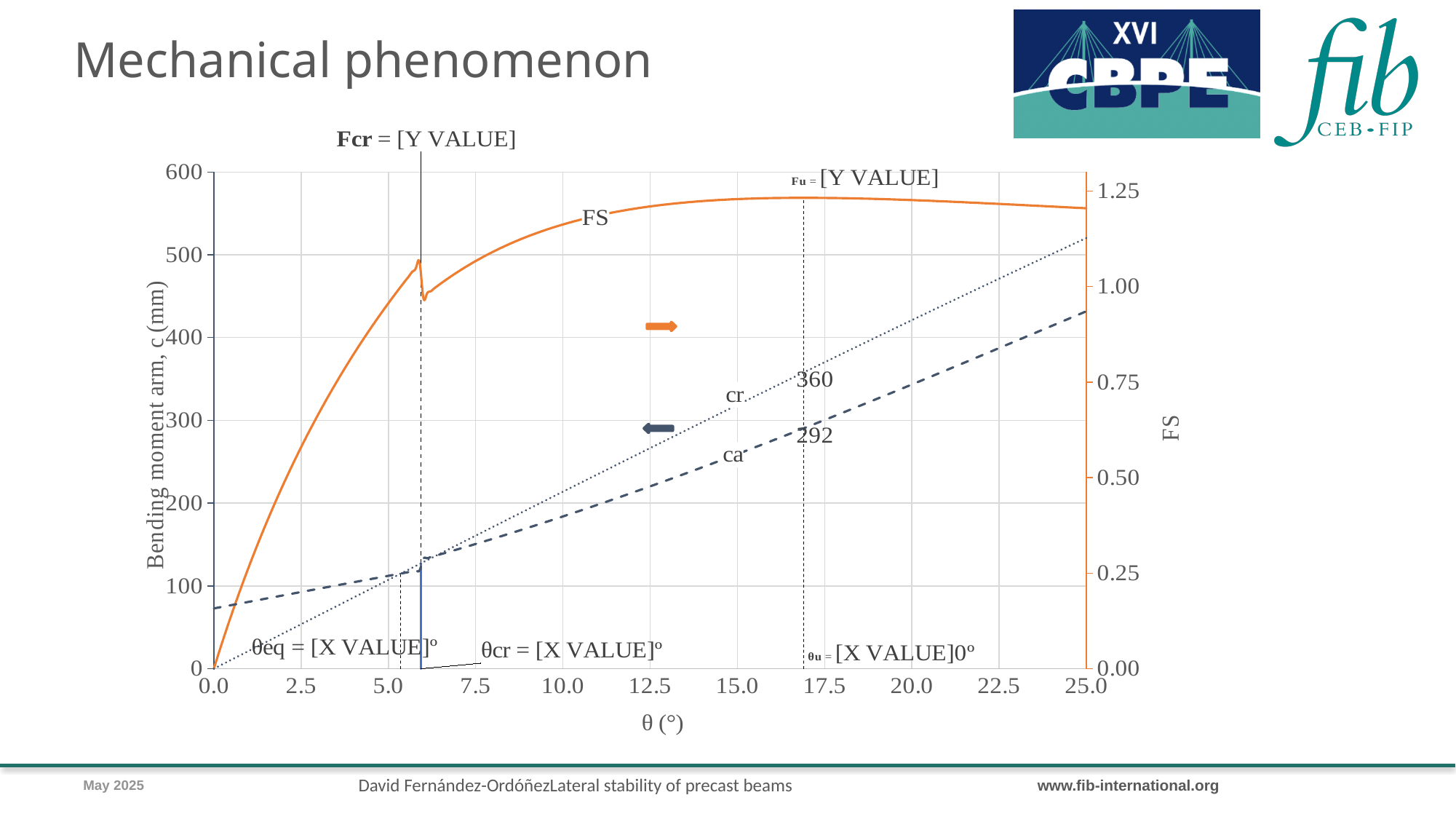
What value is labelled on the cr series at the θu line? 360 Is the ca value at θ = 0.0 greater or less than 100? less What value is labelled on the ca series at the θu line? 292 Is the FS value at θ = 25.0 greater or less than 1.00? greater What kind of chart is shown on the slide? line chart Is the FS value at θ = 2.5 greater or less than 0.75? less What is the difference between the labelled cr value (360) and the labelled ca value (292) at the θu line? 68 What is the label of the horizontal axis? θ (°) What is the label of the left vertical axis? Bending moment arm, c (mm) Does the ca series rise or fall as θ increases from 0.0 to 25.0? rise At the θu line, which series has the larger labelled value, cr or ca? cr